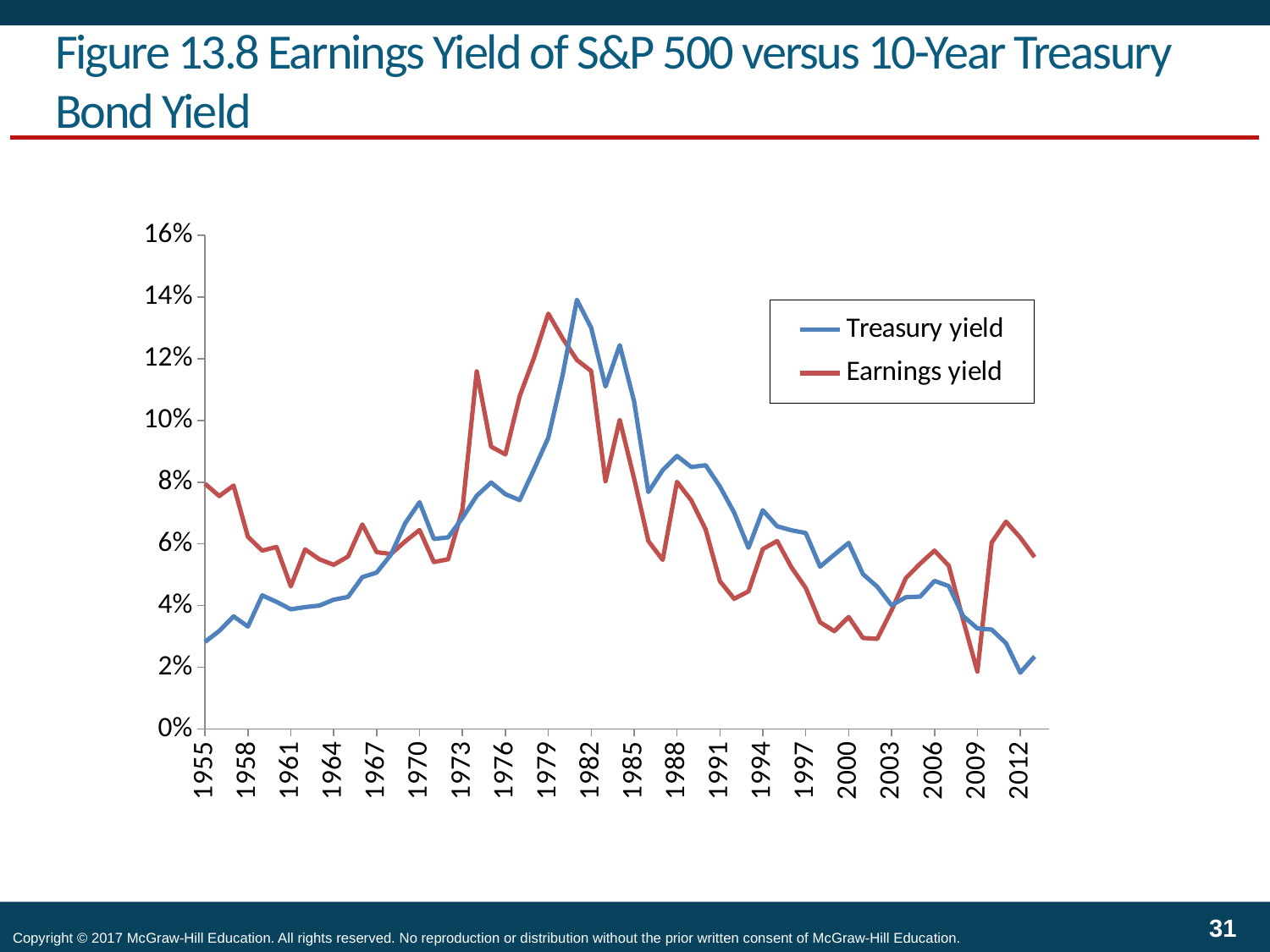
Does the Treasury yield generally rise or fall from 1981 to 2012? fall Does the Treasury yield generally rise or fall from 1955 to 1981? rise How many series does the legend list? 2 In 1955, which is higher: the Treasury yield or the Earnings yield? Earnings yield Is the Treasury yield in 1955 greater or less than 4%? less What kind of chart is shown on the slide? Line chart Is the Earnings yield in 1974 greater or less than 10%? greater Which series is drawn in red? Earnings yield In 2000, which is higher: the Treasury yield or the Earnings yield? Treasury yield What is the highest value shown on the vertical axis? 16% Is the Treasury yield in 2012 greater or less than 4%? less